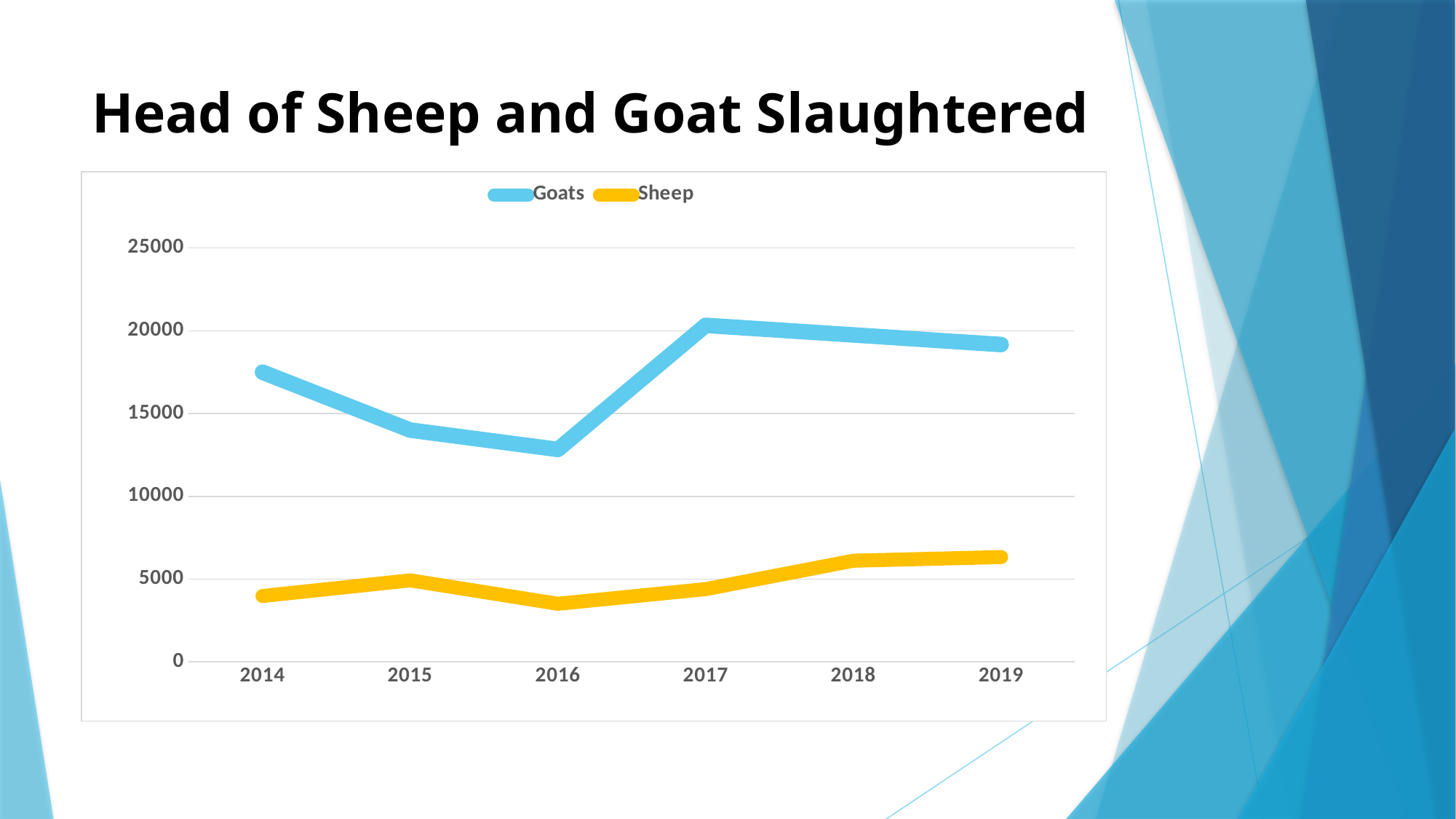
What is the title of the chart? Head of Sheep and Goat Slaughtered How many years are plotted along the x axis? 6 Which series is shown in yellow? Sheep Is the Goats value for 2016 greater or less than 15000? less Is the Goats value for 2014 greater or less than 15000? greater In which year is the Goats value lowest? 2016 Which is larger in 2019, the Goats value or the Sheep value? Goats How many series does the legend list? 2 Do the Goats values rise or fall from 2014 to 2016? fall Is the Sheep value for 2016 greater or less than 5000? less In which year is the Goats value highest? 2017 What kind of chart is shown on the slide? line chart